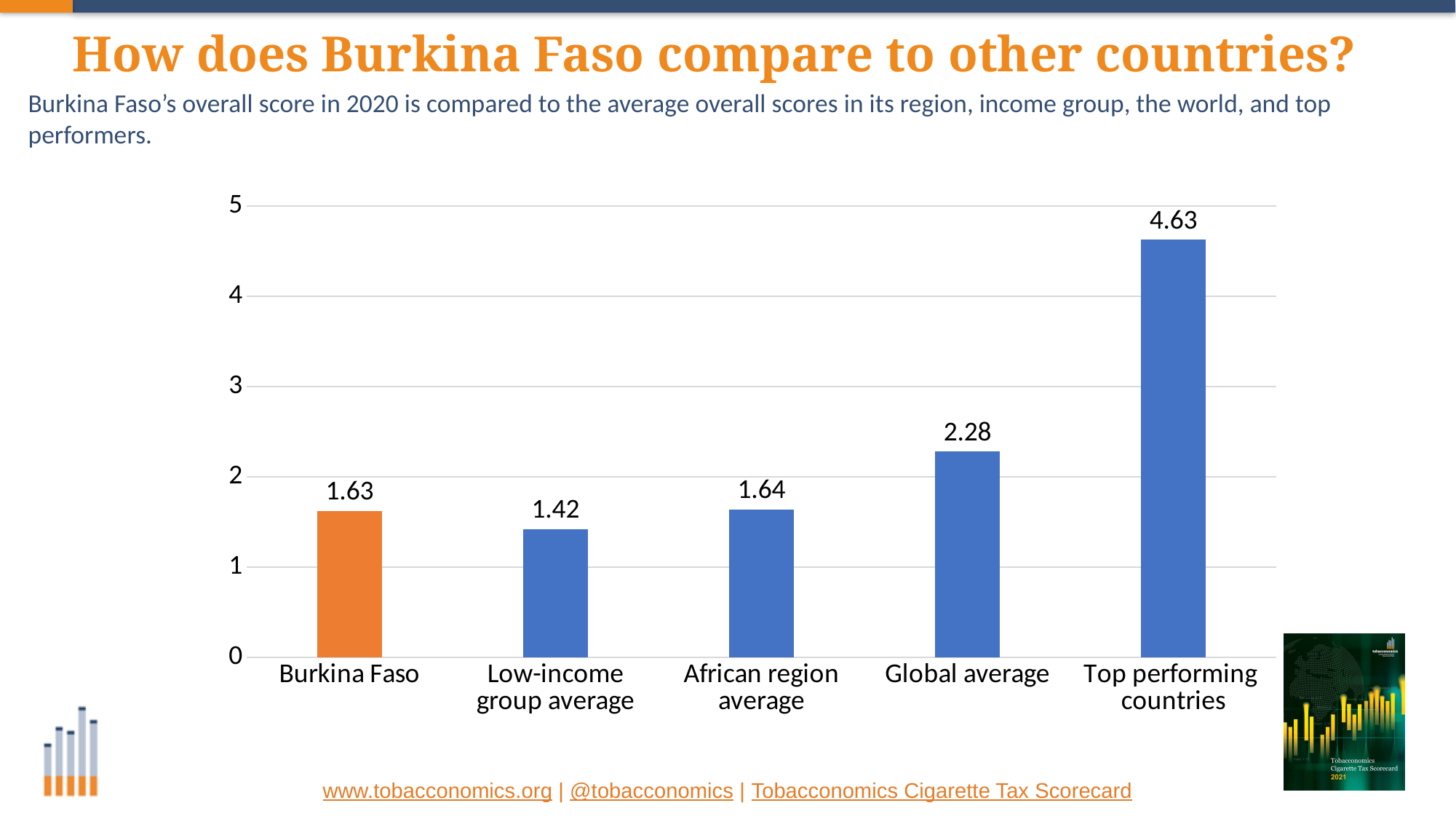
What is the value for the Global average? 2.28 Which is larger, the value for Burkina Faso or the value for the Global average? Global average What is the difference between the Global average and the Low-income group average? 0.86 What is the value for the African region average? 1.64 How many categories are shown on the x axis? 5 What is the value for the Low-income group average? 1.42 What kind of chart is shown on the slide? Bar chart What is the value for Top performing countries? 4.63 Which category has the highest value? Top performing countries What is the value for Burkina Faso? 1.63 What is the difference between the value for Top performing countries and the value for Burkina Faso? 3.00 Which category has the lowest value? Low-income group average